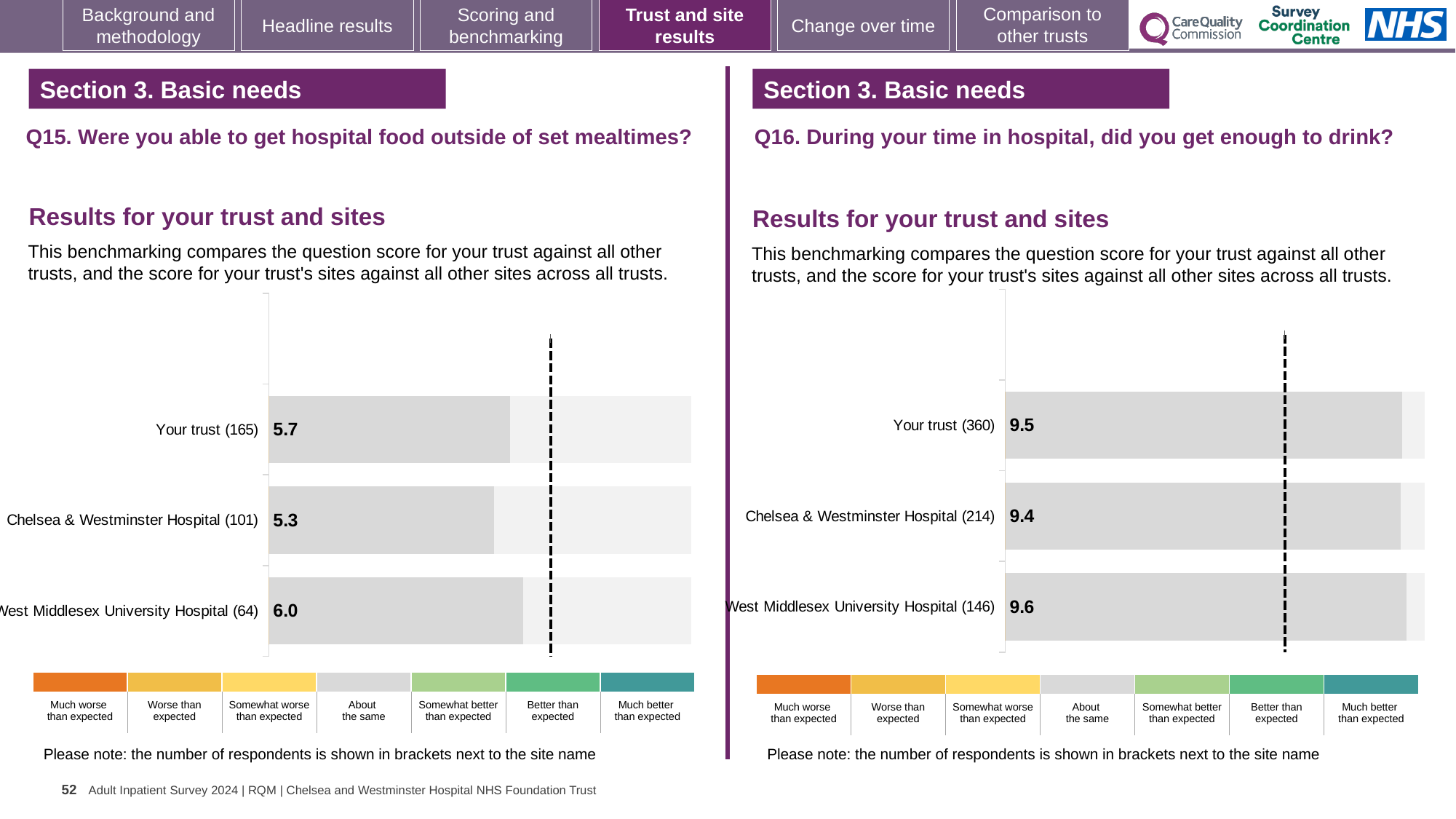
Which score is larger: Your trust in the Q15 chart or Your trust in the Q16 chart? Your trust in the Q16 chart (9.5) In the Q15 chart, how many respondents are shown in brackets for Chelsea & Westminster Hospital? 101 How many bars are plotted in the Q15 chart? 3 In the Q16 chart, which site or trust has the highest score? West Middlesex University Hospital In the Q15 chart (hospital food outside of set mealtimes), what is the score for Your trust? 5.7 In the Q15 chart, what is the score for West Middlesex University Hospital? 6.0 In the Q15 chart, what is the difference between the scores for West Middlesex University Hospital and Chelsea & Westminster Hospital? 0.7 In the Q16 chart, what is the difference between the scores for Your trust and Chelsea & Westminster Hospital? 0.1 In the Q15 chart, which site or trust has the lowest score? Chelsea & Westminster Hospital In the Q16 chart, how many respondents are shown in brackets for Your trust? 360 What type of chart is used for the Q16 results? Bar chart In the Q16 chart (did you get enough to drink), what is the score for Chelsea & Westminster Hospital? 9.4